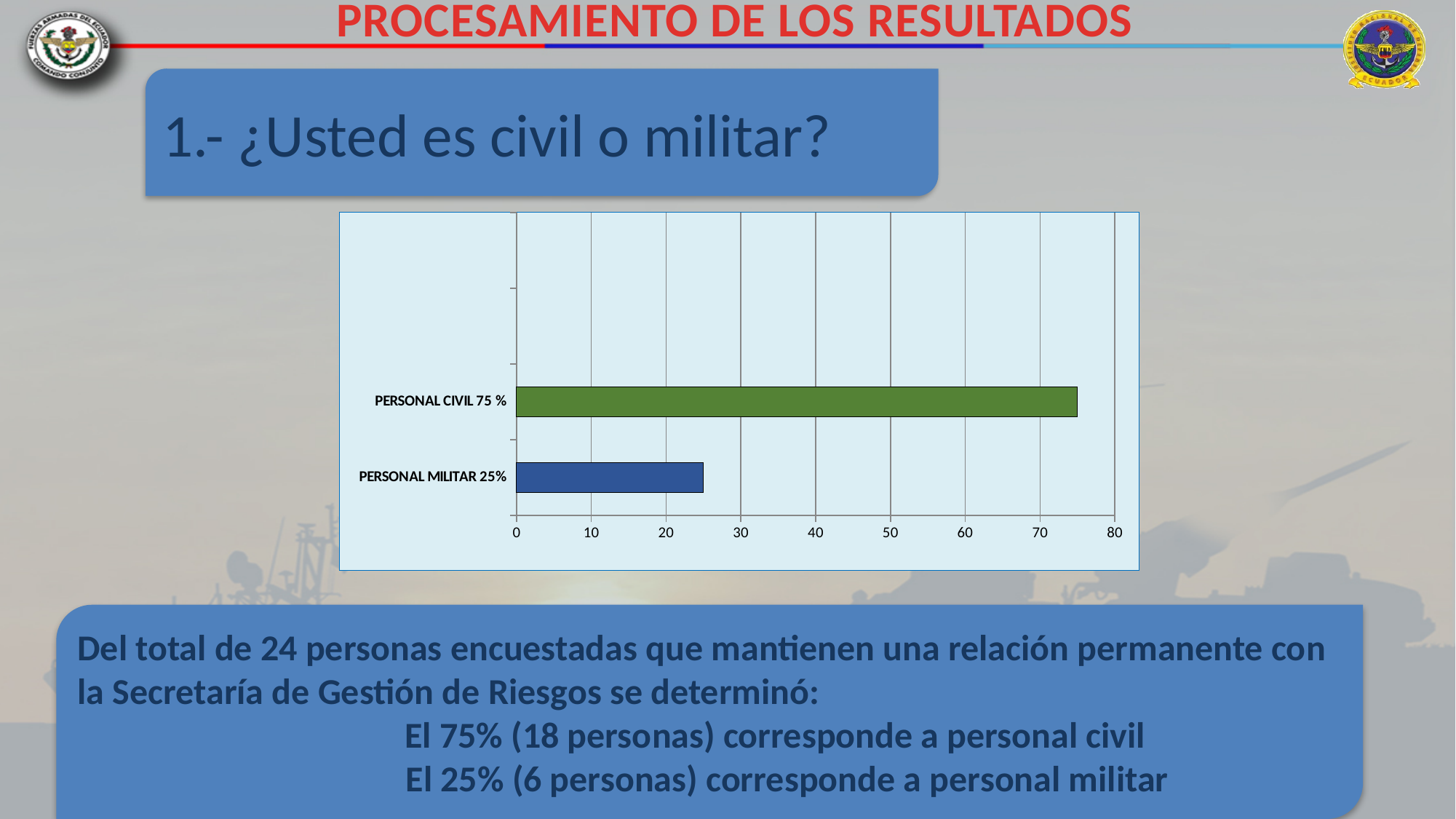
What is the highest value shown on the horizontal axis of the chart? 80 Which category has the shortest bar? PERSONAL MILITAR Which is larger, the value for PERSONAL CIVIL or for PERSONAL MILITAR? PERSONAL CIVIL Is the value for PERSONAL CIVIL greater or less than 70? greater Which category has the longest bar? PERSONAL CIVIL What percentage is shown for PERSONAL CIVIL? 75 % How many categories does the bar chart show? 2 What percentage is shown for PERSONAL MILITAR? 25% What colour is the bar for PERSONAL CIVIL? Green Is the value for PERSONAL MILITAR greater or less than 30? less What kind of chart is shown on the slide? Bar chart What is the difference in percentage points between PERSONAL CIVIL and PERSONAL MILITAR? 50